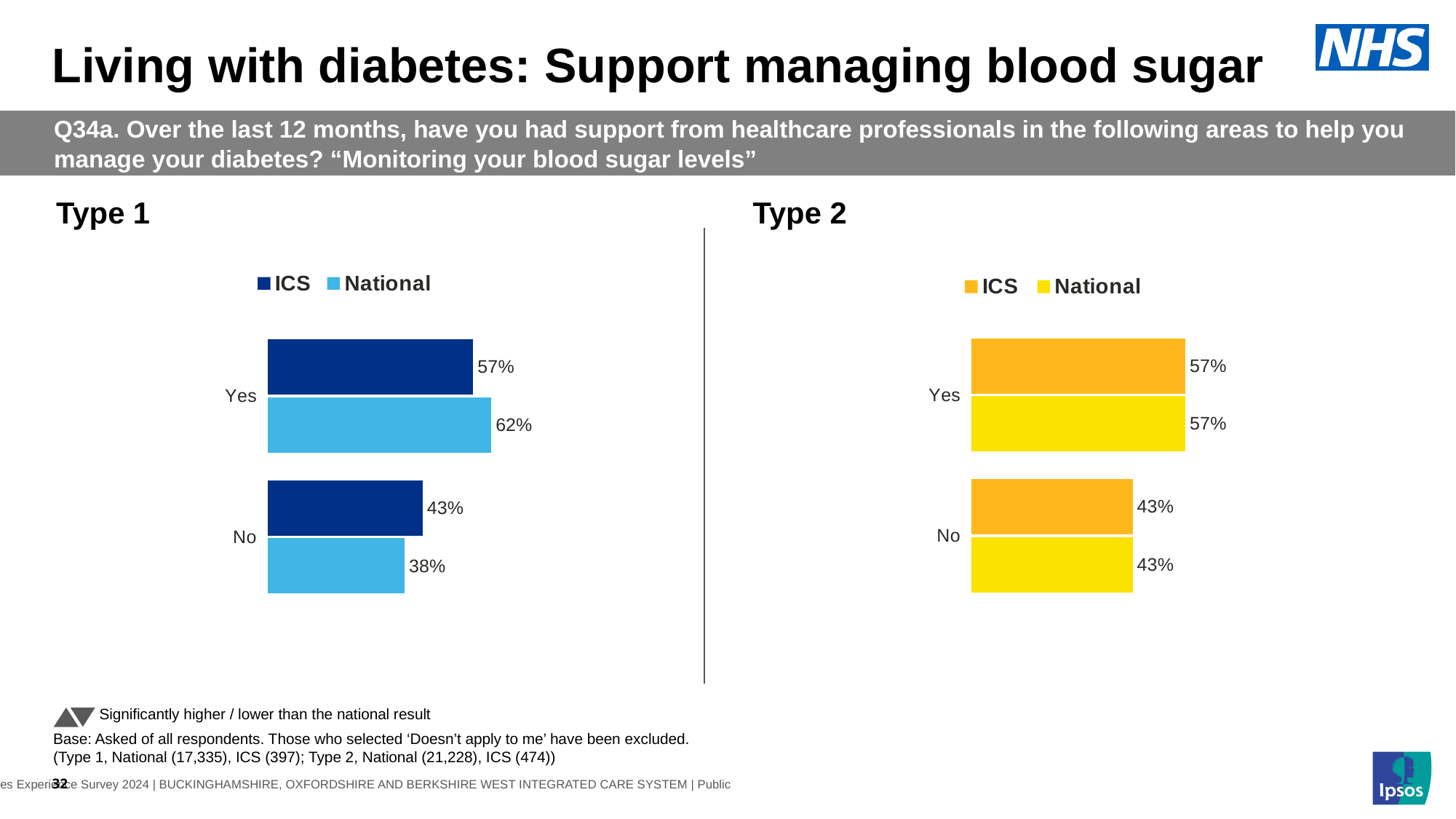
In the Type 2 chart, what is the difference between the ICS and National values for No? 0 percentage points What kind of chart is the Type 2 chart? Bar chart In the Type 1 chart, which is larger for No, ICS or National? ICS In the Type 1 chart, what is the difference between the National and ICS values for Yes? 5 percentage points How many series does the legend of the Type 2 chart list? 2 In the Type 2 chart, what is the National value for Yes? 57% In the Type 2 chart, what colour represents the National series? Yellow In the Type 1 chart, what is the National value for No? 38% In the Type 2 chart, what is the ICS value for No? 43% In the Type 1 chart, which series has the higher value for Yes? National How many categories are shown in the Type 1 chart? 2 In the Type 1 chart, what is the ICS value for Yes? 57%